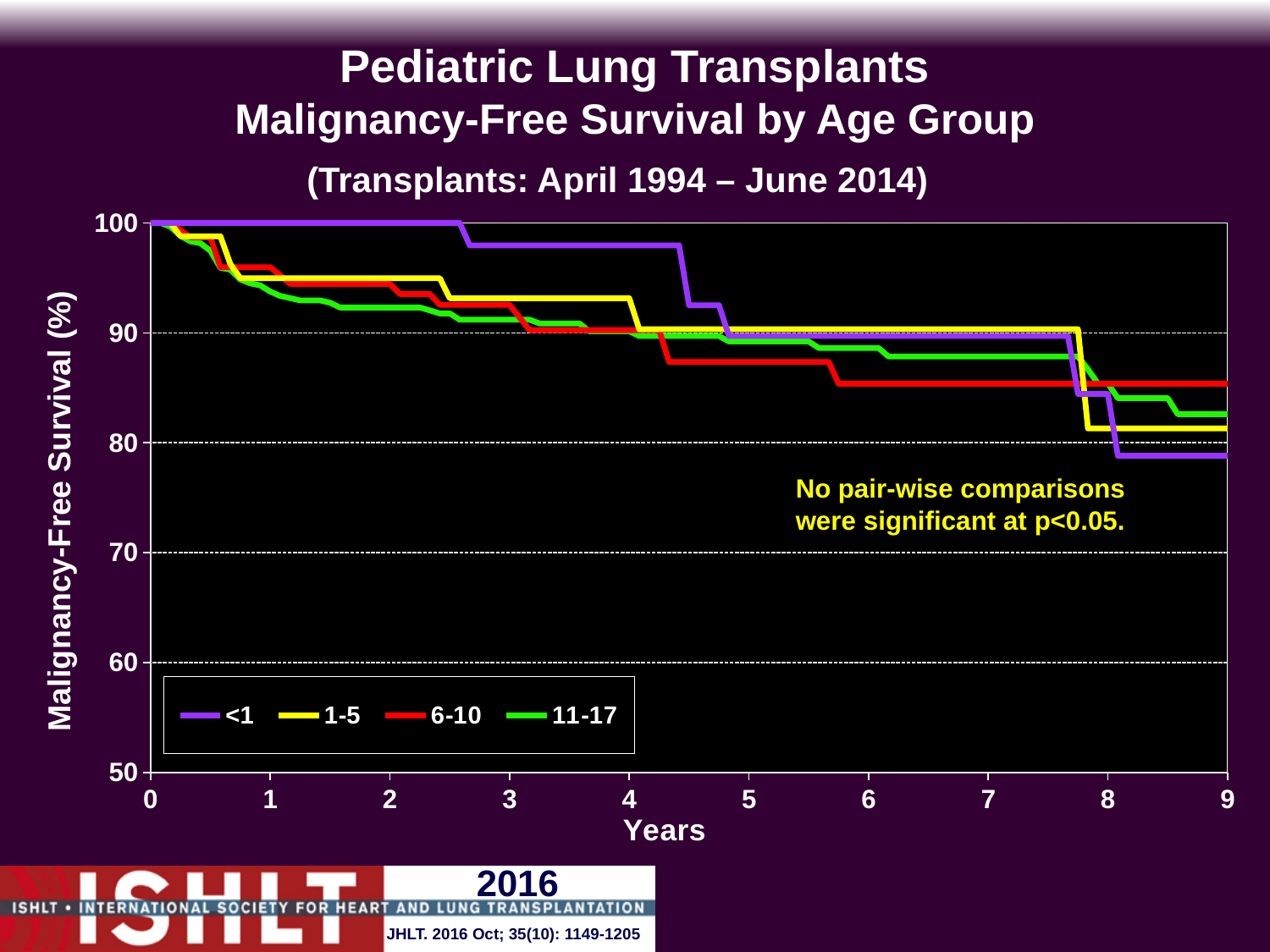
Is the malignancy-free survival for the 6-10 age group at year 5 greater or less than 90? less Is the malignancy-free survival for the <1 age group at year 9 greater or less than 80? less Is the malignancy-free survival for the <1 age group at year 3 greater or less than 90? greater What kind of chart is shown on the slide? line chart How many age groups does the legend list? 4 Which age group has the lowest malignancy-free survival at year 9? <1 What is the malignancy-free survival for the <1 age group at year 2? 100 What is the label of the x axis? Years Do the malignancy-free survival curves rise or fall as years increase? fall At year 6, which age group has higher malignancy-free survival, 1-5 or 6-10? 1-5 Which age group has the highest malignancy-free survival at year 4? <1 Which age groups are listed in the legend? <1, 1-5, 6-10, 11-17